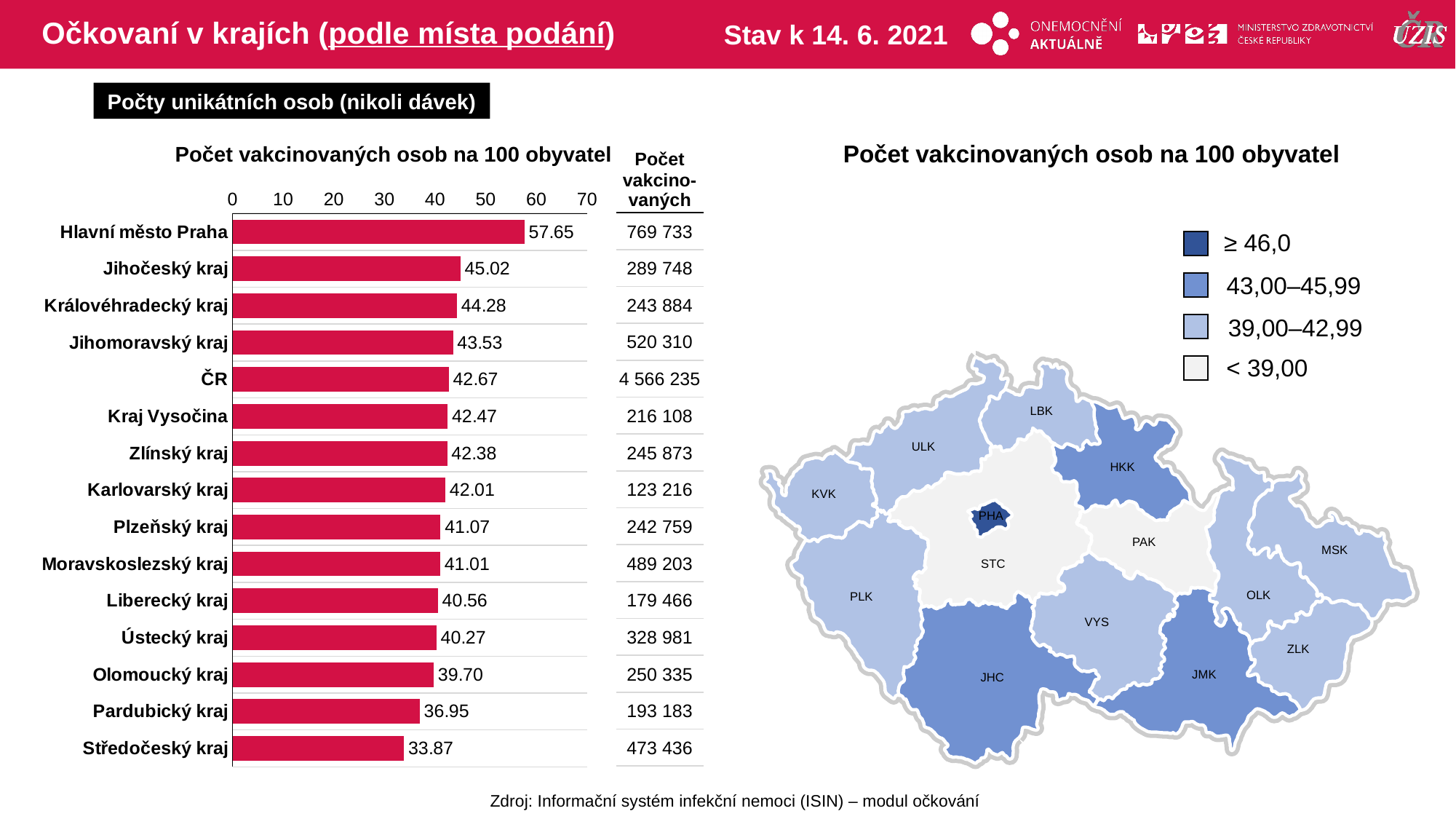
What kind of chart is shown on the left side of the slide? bar chart In the bar chart, what is the value for Hlavní město Praha? 57.65 In the bar chart, is the value for Pardubický kraj greater or less than 40? less How many bars are shown in the bar chart? 15 In the bar chart, what is the value for Středočeský kraj? 33.87 In the table next to the bar chart, what is the 'Počet vakcinovaných' value for ČR? 4 566 235 In the bar chart, which region has the highest number of vaccinated persons per 100 inhabitants? Hlavní město Praha In the bar chart, which region has the lowest number of vaccinated persons per 100 inhabitants? Středočeský kraj In the bar chart, what is the value for ČR? 42.67 In the bar chart, which has a higher value: Jihočeský kraj or Královéhradecký kraj? Jihočeský kraj How many colour categories does the legend of the map on the right list? 4 In the bar chart, what is the difference between the values for Hlavní město Praha and Středočeský kraj? 23.78